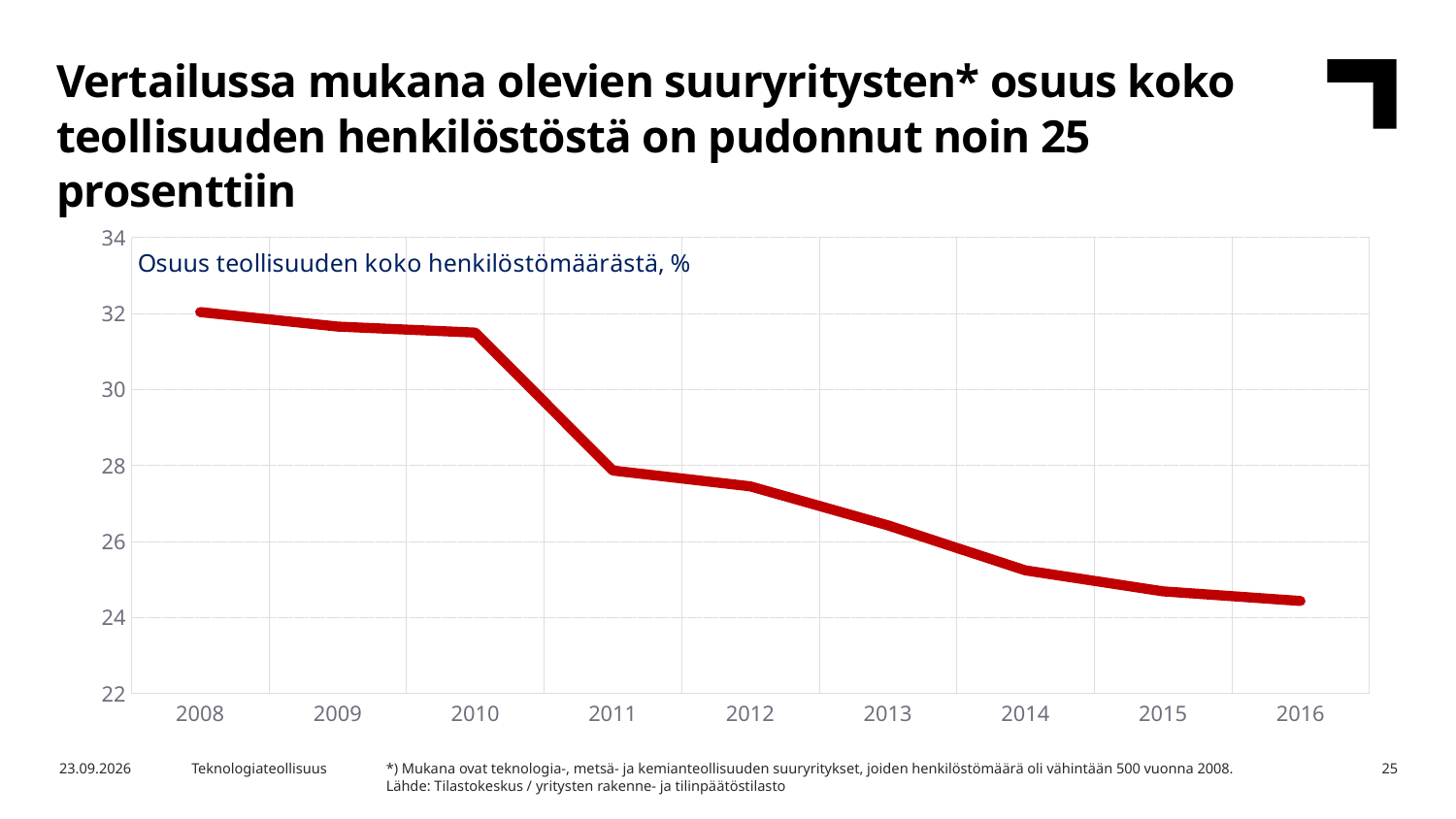
Is the value for 2014 greater or less than 26? less What kind of chart is shown on the slide? line chart What is the label shown inside the chart area describing the plotted series? Osuus teollisuuden koko henkilöstömäärästä, % Do the values rise or fall from 2008 to 2016? fall Is the value for 2012 greater or less than 26? greater Which year has the lowest value in the chart? 2016 How many years are plotted on the x axis of the chart? 9 Is the value for 2016 greater or less than 24? greater Which year has the highest value in the chart? 2008 Which year has the larger value, 2013 or 2015? 2013 Which year has the larger value, 2010 or 2011? 2010